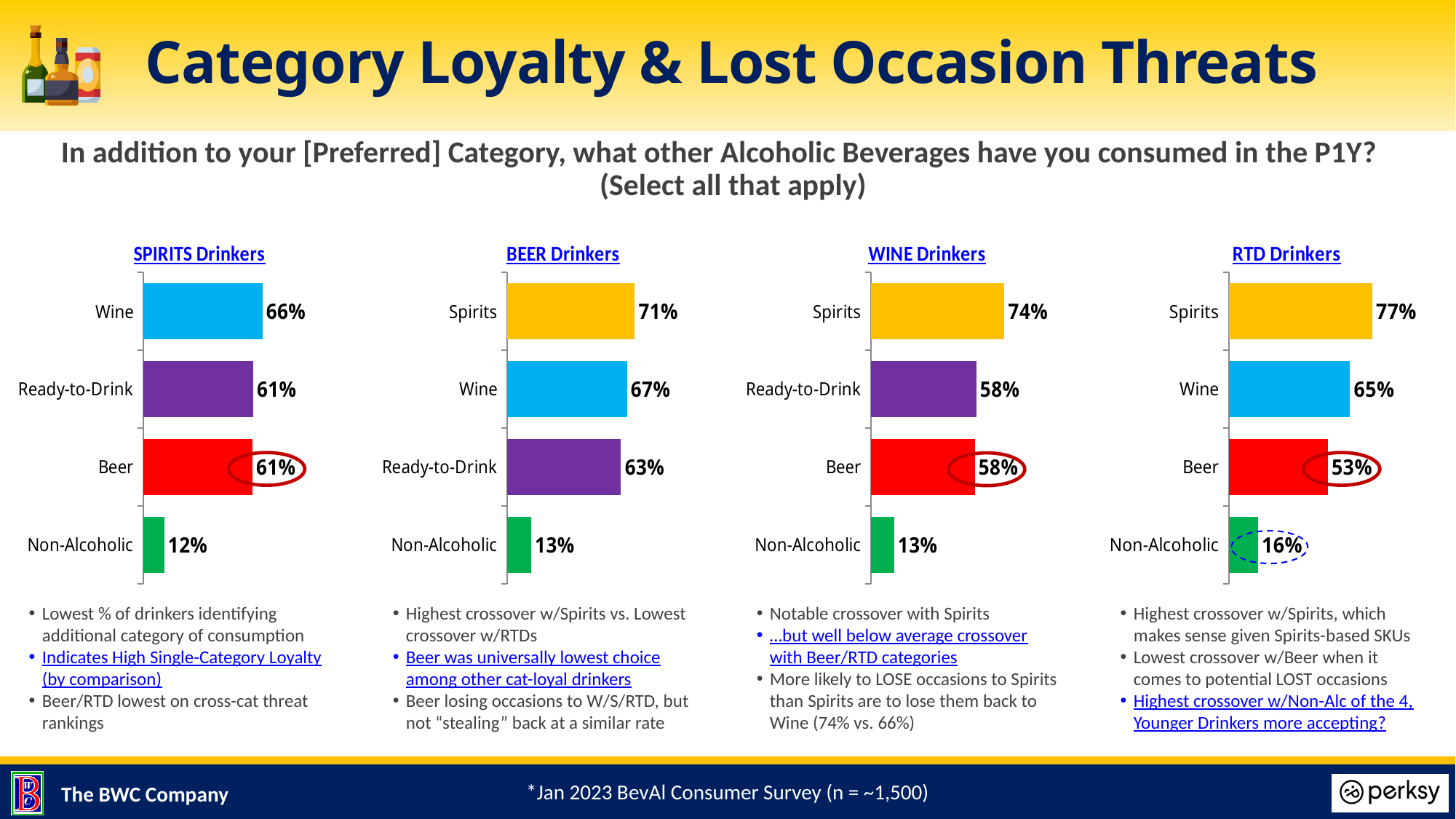
How many categories are shown in the BEER Drinkers chart? 4 In the WINE Drinkers chart, what is the difference between the Spirits value and the Non-Alcoholic value? 61% In the RTD Drinkers chart, which is larger, the value for Wine or the value for Beer? Wine In the SPIRITS Drinkers chart, which category has the lowest value? Non-Alcoholic In the SPIRITS Drinkers chart, what is the value for Wine? 66% In the BEER Drinkers chart, what is the value for Ready-to-Drink? 63% In the RTD Drinkers chart, which category has the highest value? Spirits In the WINE Drinkers chart, what is the value for Non-Alcoholic? 13% In the BEER Drinkers chart, what is the difference between the Spirits value and the Wine value? 4% What kind of chart is the WINE Drinkers chart? Bar chart In the RTD Drinkers chart, what is the value for Beer? 53% How many charts are shown on the slide? 4